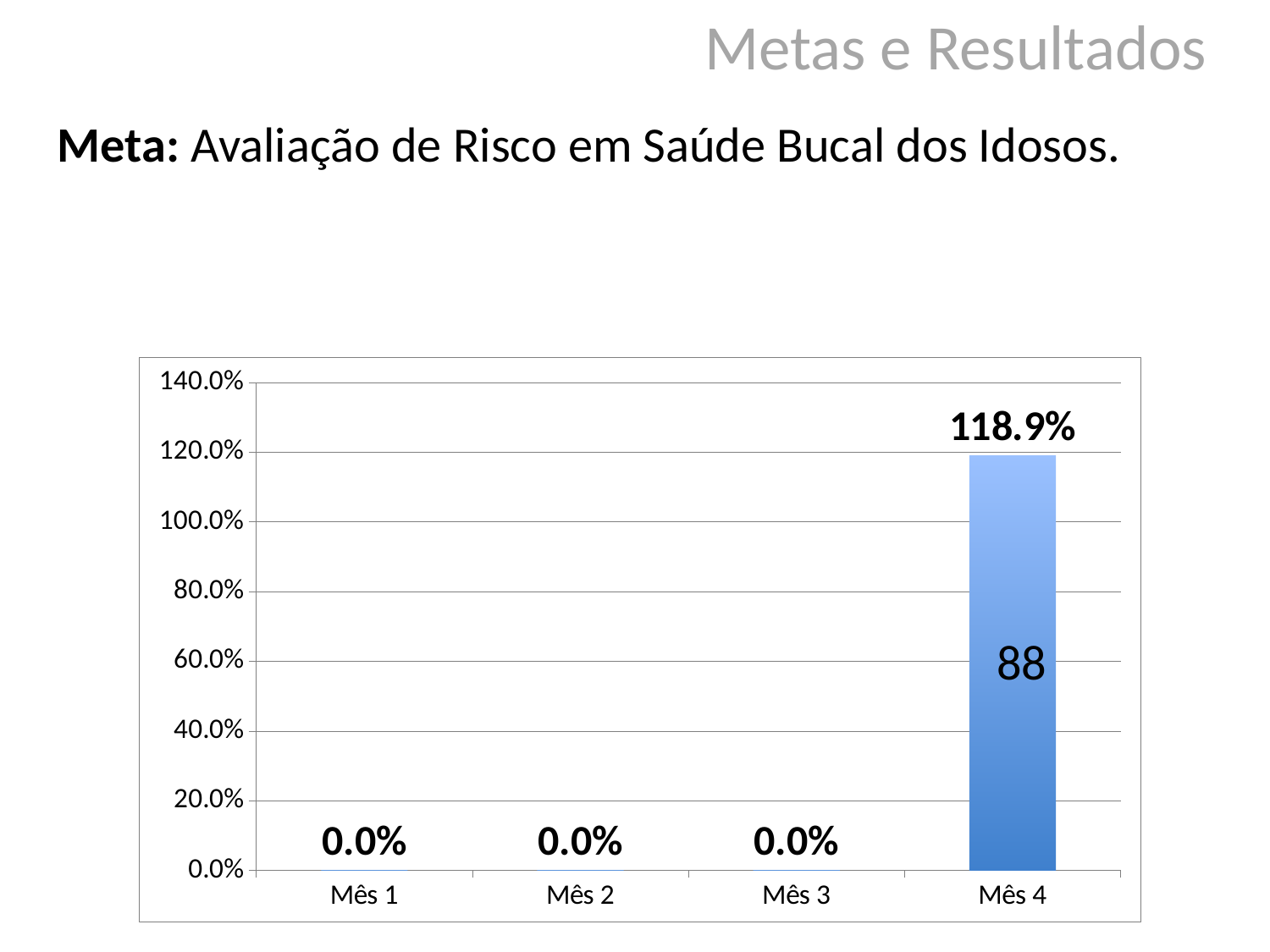
What is the difference between the values for Mês 4 and Mês 2? 118.9% What is the value for Mês 1? 0.0% How many months are shown on the x axis? 4 Is the value for Mês 4 greater or less than 100.0%? greater Which month has the highest value? Mês 4 What is the highest value shown on the y axis? 140.0% What is the value for Mês 3? 0.0% What number is printed inside the bar for Mês 4? 88 Do the values rise or fall from Mês 3 to Mês 4? rise What is the value for Mês 4? 118.9% What kind of chart is shown on the slide? bar chart Which is larger, the value for Mês 4 or the value for Mês 3? Mês 4